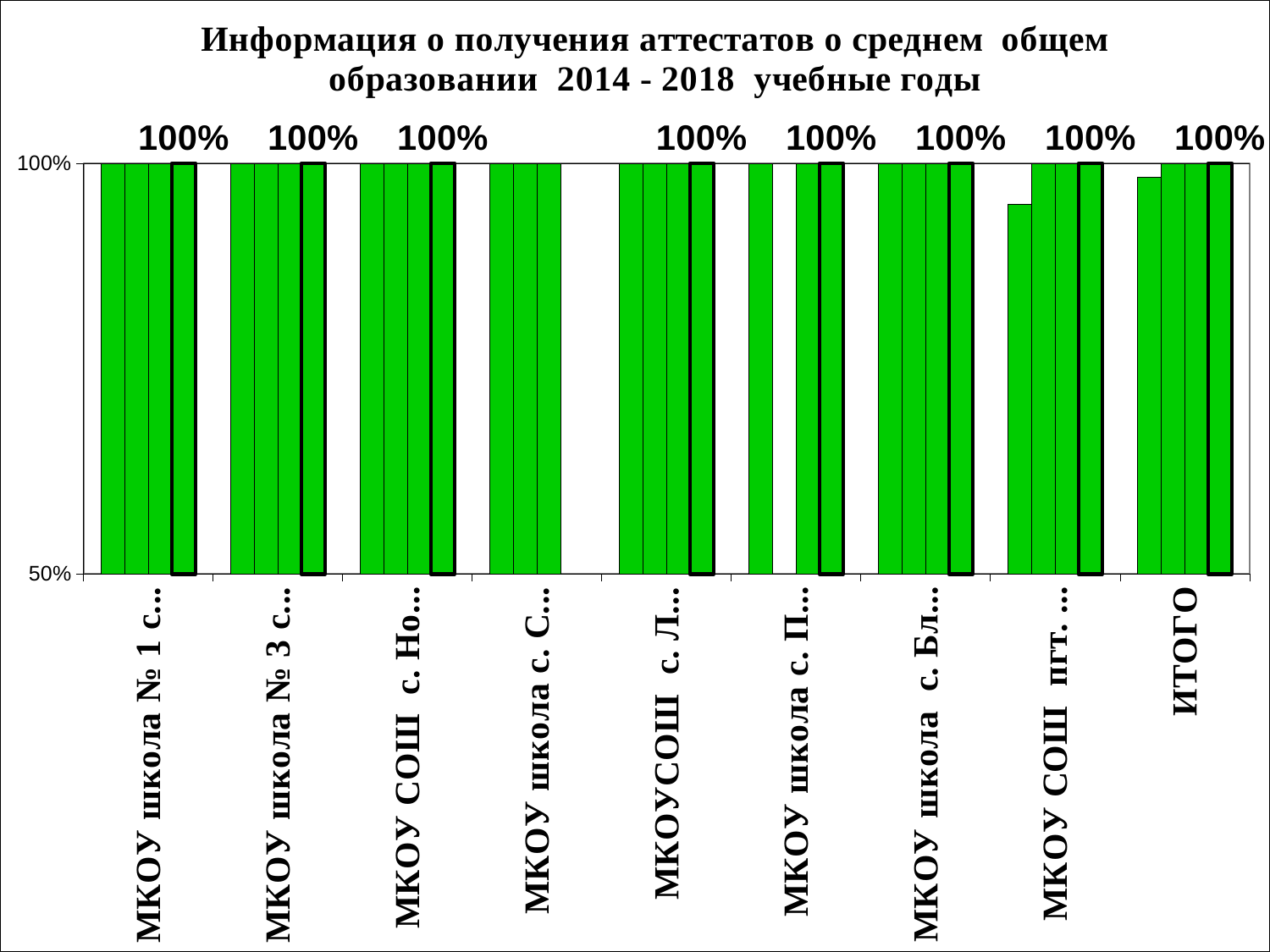
What value is labelled for the outlined bar of the category МКОУ школа № 1 с...? 100% Which category has no 100% data label above its bars? МКОУ школа с. С... How many categories are shown along the x axis of the chart? 9 How many bars are plotted for the ИТОГО category? 4 Is the first (leftmost) bar of the category МКОУ СОШ пгт. ... greater or less than 100%? less What is the lowest value shown on the vertical axis? 50% What kind of chart is shown on the slide? bar chart What value is labelled for the outlined bar of the ИТОГО category? 100% How many categories have a 100% data label printed above their bars? 8 What is the title of the chart? Информация о получения аттестатов о среднем общем образовании 2014 - 2018 учебные годы Is the first (leftmost) bar of the ИТОГО category greater or less than 50%? greater What value is labelled for the outlined bar of the category МКОУ СОШ пгт. ...? 100%